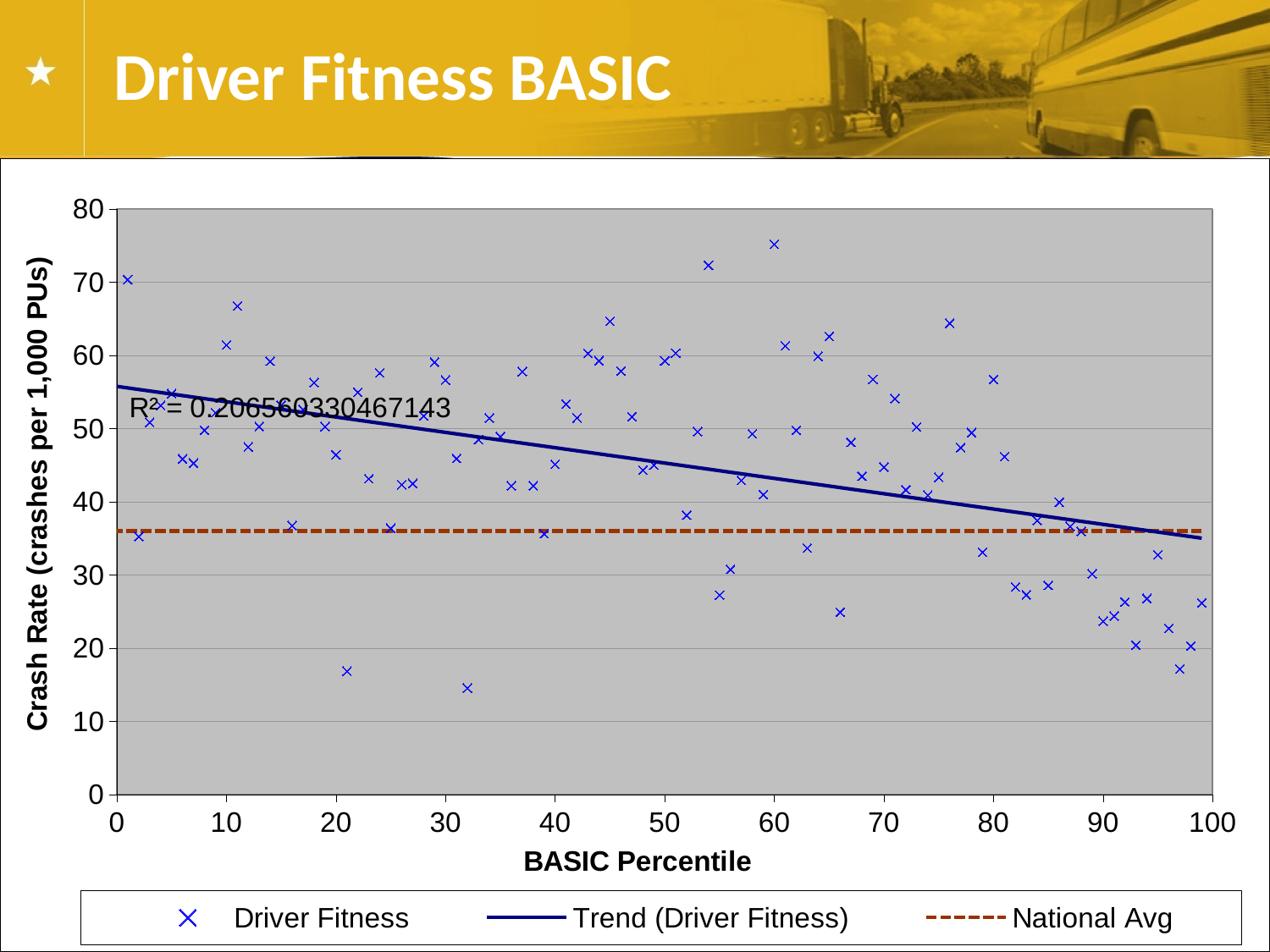
How many entries does the legend list? 3 What is the title of the x axis? BASIC Percentile Does the Trend (Driver Fitness) line rise or fall as BASIC Percentile increases? fall What is the R² value printed on the chart? R² = 0.206560330467143 Is the National Avg line greater or less than 40 crashes per 1,000 PUs? less What kind of chart is shown on the slide? scatter chart Which is larger at BASIC Percentile 0: the Trend (Driver Fitness) line or the National Avg line? Trend (Driver Fitness) Is the lowest Driver Fitness point greater or less than 20 crashes per 1,000 PUs? less Is the highest Driver Fitness point greater or less than 70 crashes per 1,000 PUs? greater